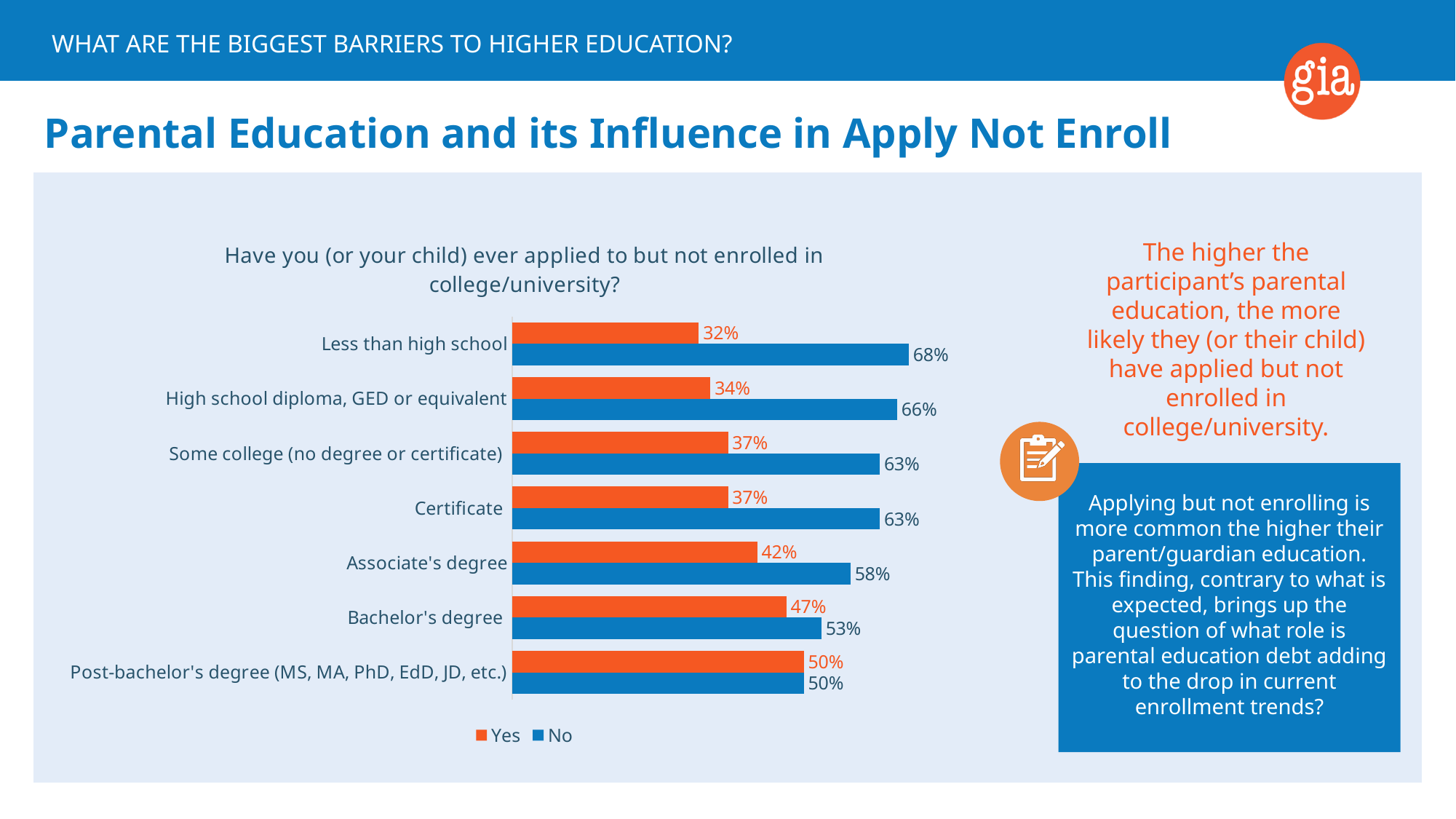
What colour represents the "Yes" series in the chart? Orange What is the difference between the "No" and "Yes" values for Less than high school? 36% How many series does the legend list? 2 Which category has the highest "Yes" value? Post-bachelor's degree (MS, MA, PhD, EdD, JD, etc.) Which is larger for High school diploma, GED or equivalent: the "Yes" value or the "No" value? No Which category has the lowest "Yes" value? Less than high school What kind of chart is shown on the slide? Bar chart What is the "Yes" value for Bachelor's degree? 47% What is the "Yes" value for Less than high school? 32% How many parental education categories are shown in the chart? 7 What is the "No" value for Associate's degree? 58% Do the "Yes" values rise or fall as parental education increases from Less than high school to Post-bachelor's degree? Rise